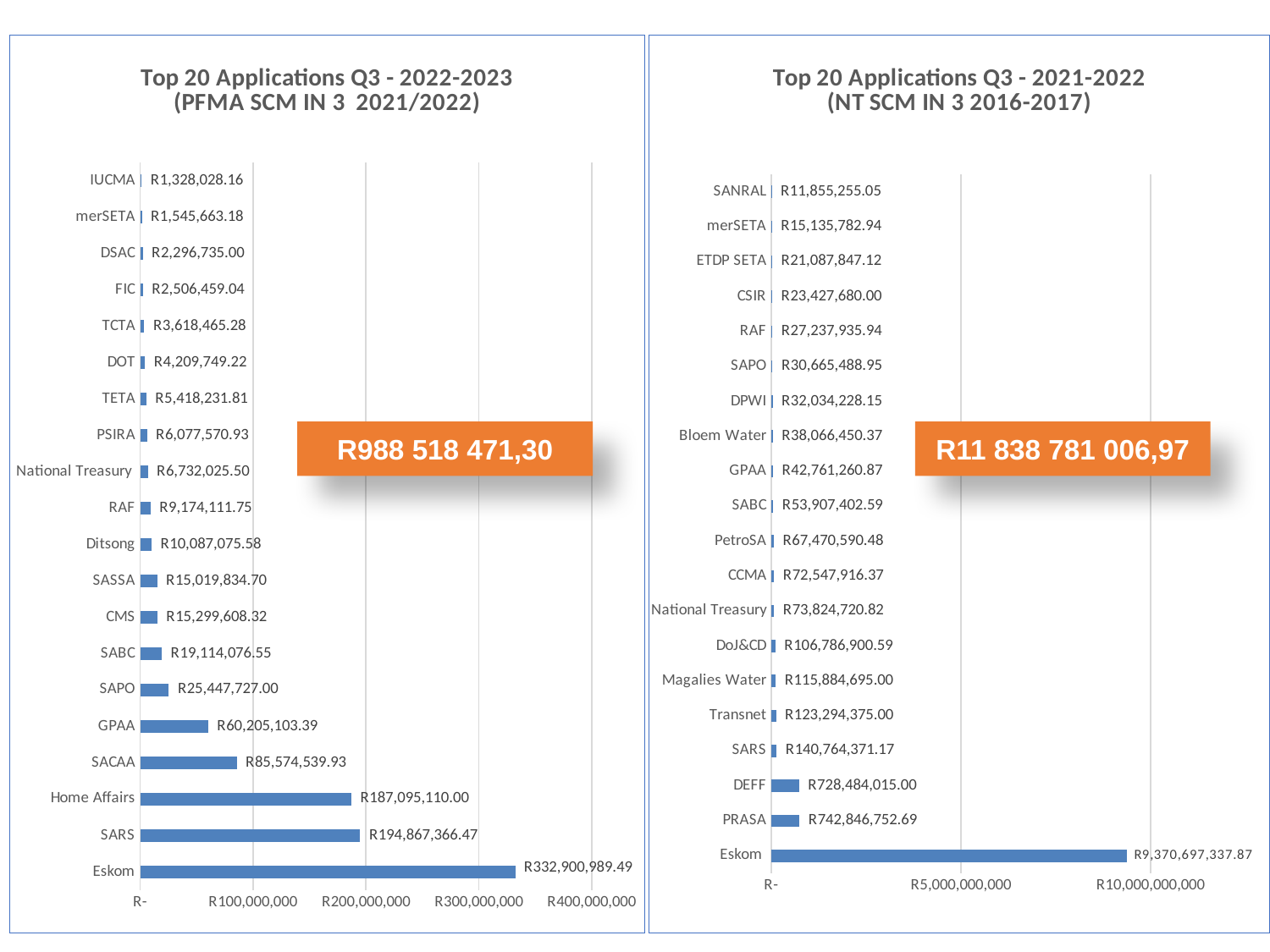
In the 'Top 20 Applications Q3 - 2022-2023' chart on the left, which is larger, the value for GPAA or the value for SACAA? SACAA In the 'Top 20 Applications Q3 - 2022-2023' chart on the left, what is the value for Home Affairs? R187,095,110.00 What total is shown in the orange box on the 'Top 20 Applications Q3 - 2022-2023' chart on the left? R988 518 471,30 In the 'Top 20 Applications Q3 - 2021-2022' chart on the right, what is the difference between the values for PRASA and DEFF? R14,362,737.69 In the 'Top 20 Applications Q3 - 2022-2023' chart on the left, which category has the lowest value? IUCMA In the 'Top 20 Applications Q3 - 2022-2023' chart on the left, what is the value for Eskom? R332,900,989.49 In the 'Top 20 Applications Q3 - 2022-2023' chart on the left, how many categories are plotted? 20 In the 'Top 20 Applications Q3 - 2021-2022' chart on the right, which category has the highest value? Eskom What kind of chart is the 'Top 20 Applications Q3 - 2021-2022' chart on the right? Bar chart In the 'Top 20 Applications Q3 - 2021-2022' chart on the right, what is the value for Transnet? R123,294,375.00 In the 'Top 20 Applications Q3 - 2022-2023' chart on the left, what is the difference between the values for SARS and Home Affairs? R7,772,256.47 In the 'Top 20 Applications Q3 - 2021-2022' chart on the right, what is the value for Eskom? R9,370,697,337.87